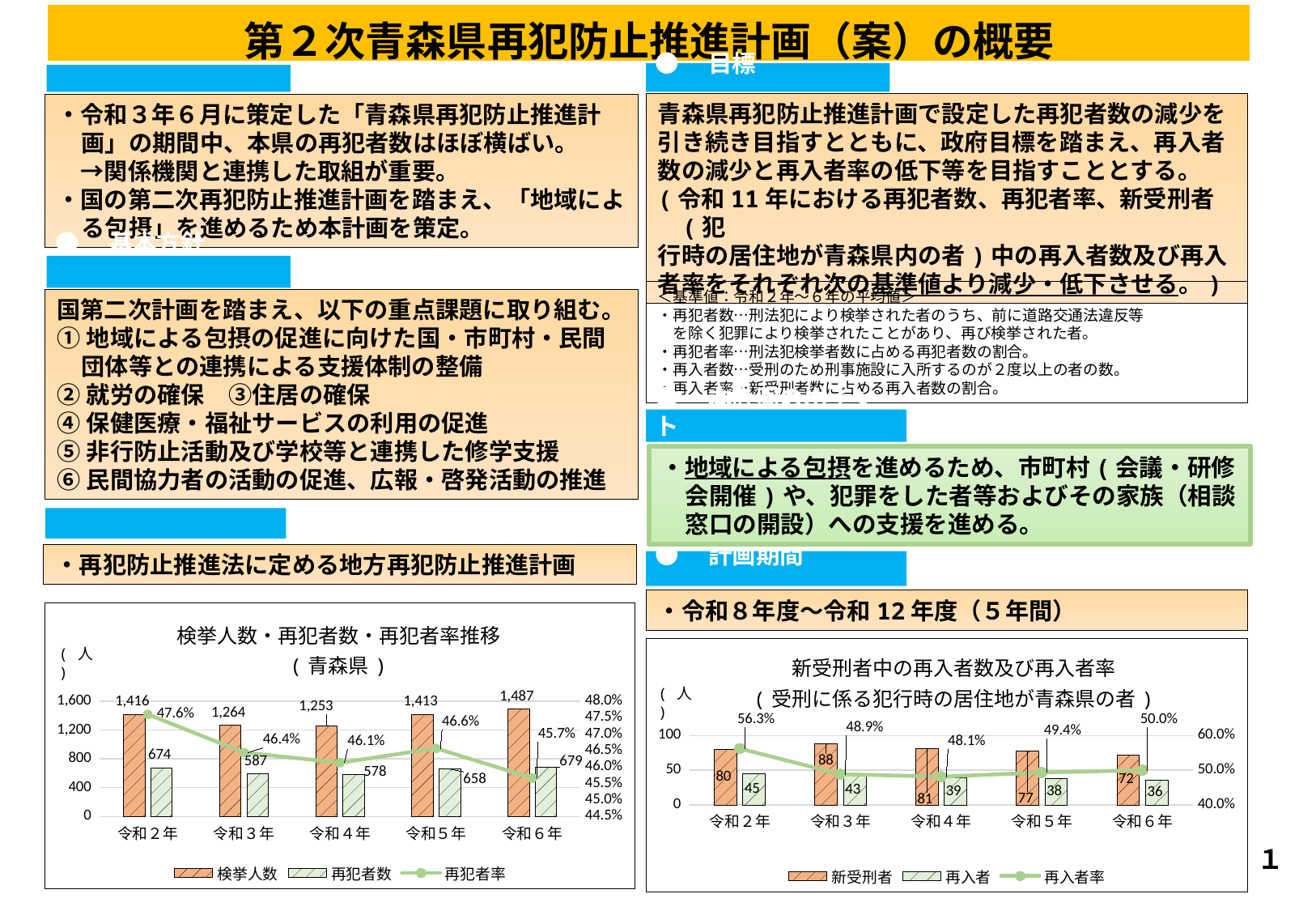
In the right chart (新受刑者中の再入者数及び再入者率), what is the 新受刑者 value for 令和３年? 88 In the left chart (検挙人数・再犯者数・再犯者率推移), what is the 再犯者率 for 令和２年? 47.6% In the right chart (新受刑者中の再入者数及び再入者率), which year has the lowest 再入者 value? 令和６年 In the right chart (新受刑者中の再入者数及び再入者率), does the 再入者 value rise or fall from 令和２年 to 令和６年? fall In the right chart (新受刑者中の再入者数及び再入者率), how many years are shown on the x axis? 5 In the left chart (検挙人数・再犯者数・再犯者率推移), what is the 検挙人数 value for 令和６年? 1,487 In the left chart (検挙人数・再犯者数・再犯者率推移), which year has the lowest 再犯者数? 令和４年 In the left chart (検挙人数・再犯者数・再犯者率推移), what is the difference between the 検挙人数 for 令和２年 and 令和３年? 152 In the right chart (新受刑者中の再入者数及び再入者率), which is larger, the 新受刑者 value for 令和２年 or for 令和６年? 令和２年 In the right chart (新受刑者中の再入者数及び再入者率), what is the 再入者率 for 令和２年? 56.3% In the left chart (検挙人数・再犯者数・再犯者率推移), which year has the highest 再犯者率? 令和２年 In the left chart (検挙人数・再犯者数・再犯者率推移), how many series does the legend list? 3